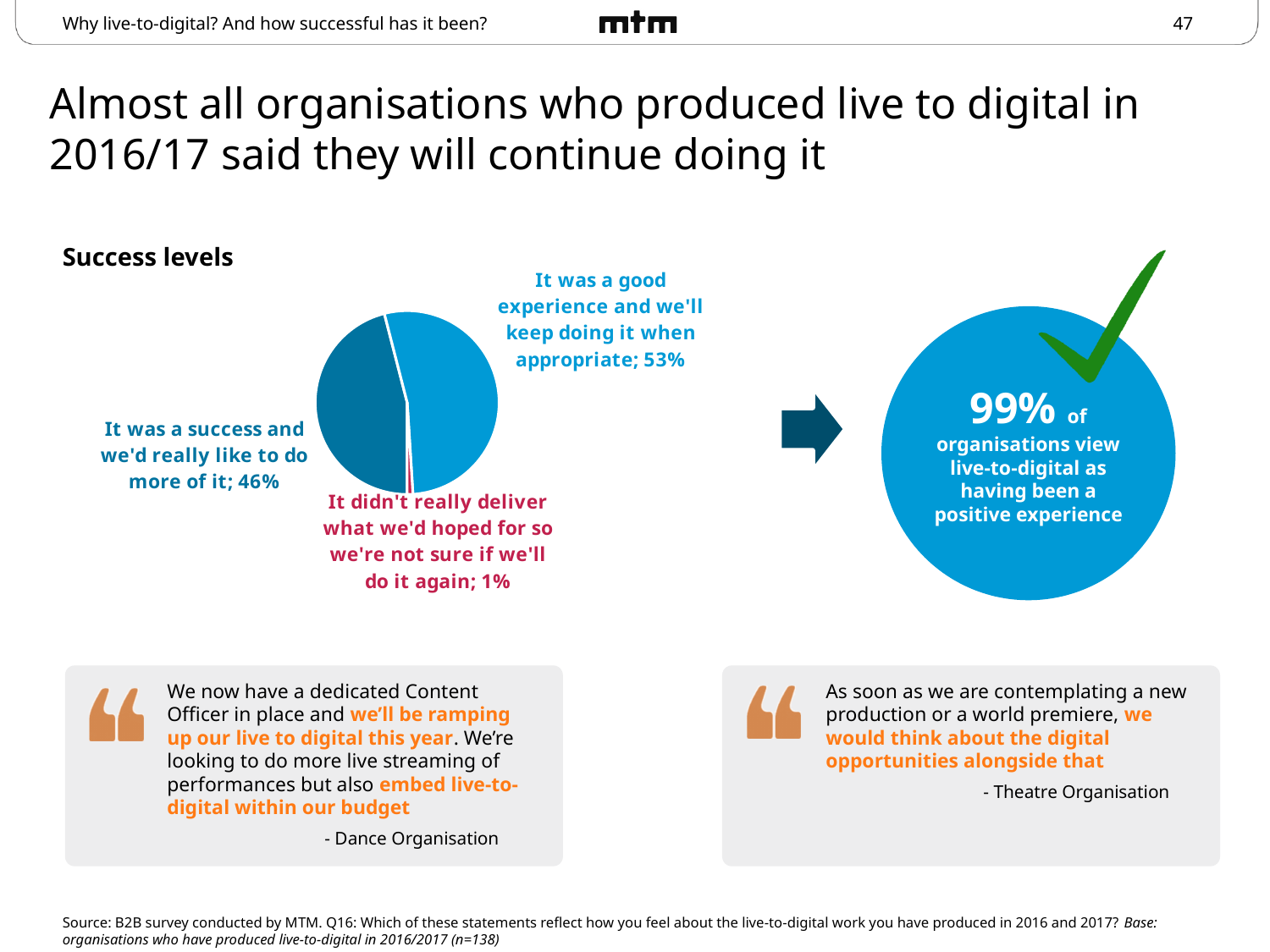
Which response has the smallest slice of the pie chart? It didn't really deliver what we'd hoped for so we're not sure if we'll do it again What share of organisations said 'It was a success and we'd really like to do more of it'? 46% What is the title of the pie chart section? Success levels What is the difference in percentage points between the 'good experience' slice and the 'success' slice? 7 What is the combined share of the two positive responses ('good experience' and 'success')? 99% Which is larger: the 'It was a success' slice or the 'It didn't really deliver' slice? It was a success and we'd really like to do more of it What share of organisations said 'It didn't really deliver what we'd hoped for so we're not sure if we'll do it again'? 1% What kind of chart is shown under 'Success levels'? pie chart What share of organisations said 'It was a good experience and we'll keep doing it when appropriate'? 53% How many slices does the pie chart have? 3 Which response has the largest slice of the pie chart? It was a good experience and we'll keep doing it when appropriate